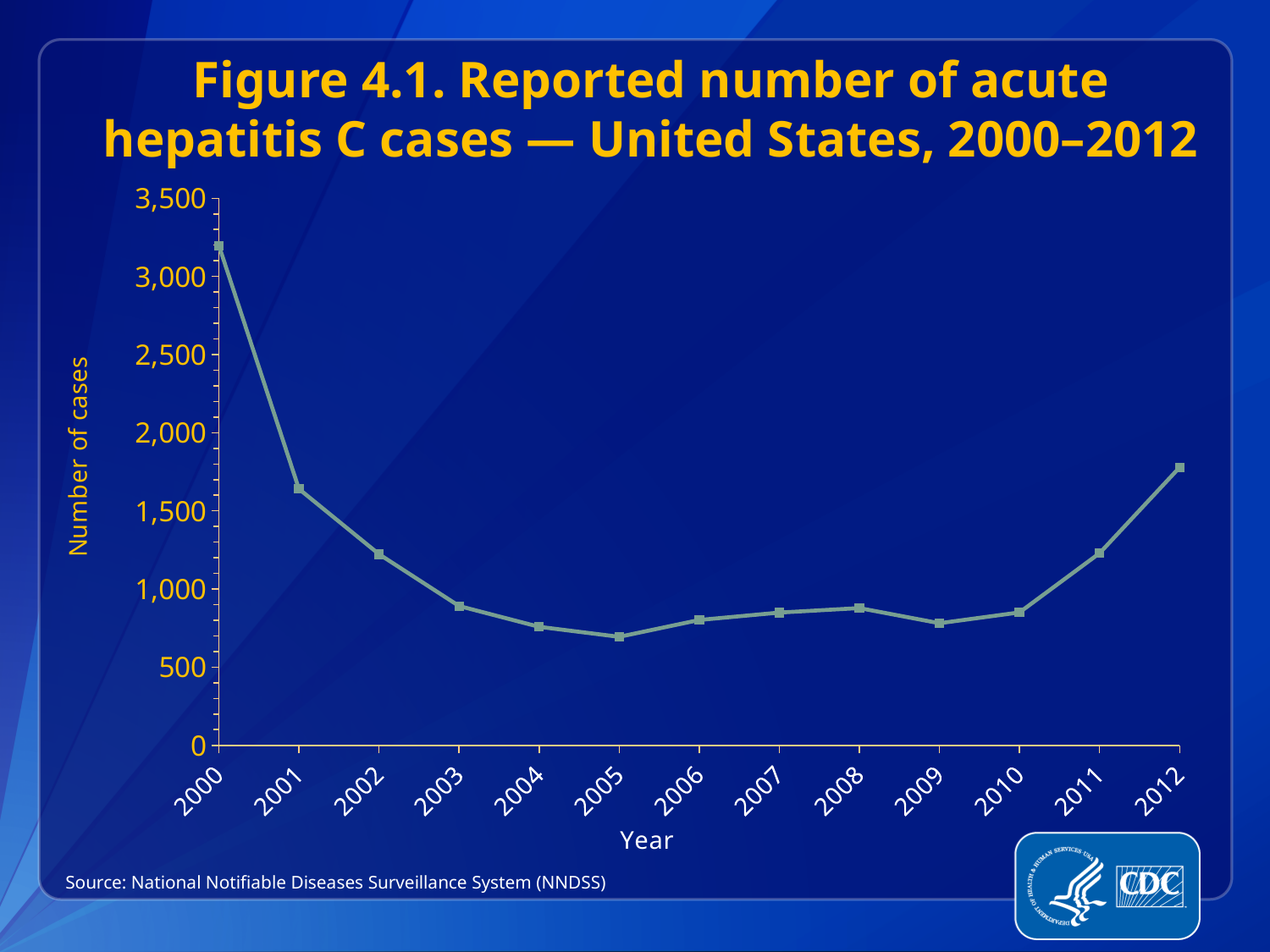
Is the value for 2012 greater or less than 1,500? greater What kind of chart is shown on the slide? line chart What is the label of the y axis of the chart? Number of cases Is the value for 2005 greater or less than 1,000? less Is the value for 2000 greater or less than 3,000? greater Which year has the highest reported number of acute hepatitis C cases? 2000 Which year has the lowest reported number of acute hepatitis C cases? 2005 Do the reported cases rise or fall from 2010 to 2012? rise Do the reported cases rise or fall from 2000 to 2005? fall How many years are plotted on the x axis of the chart? 13